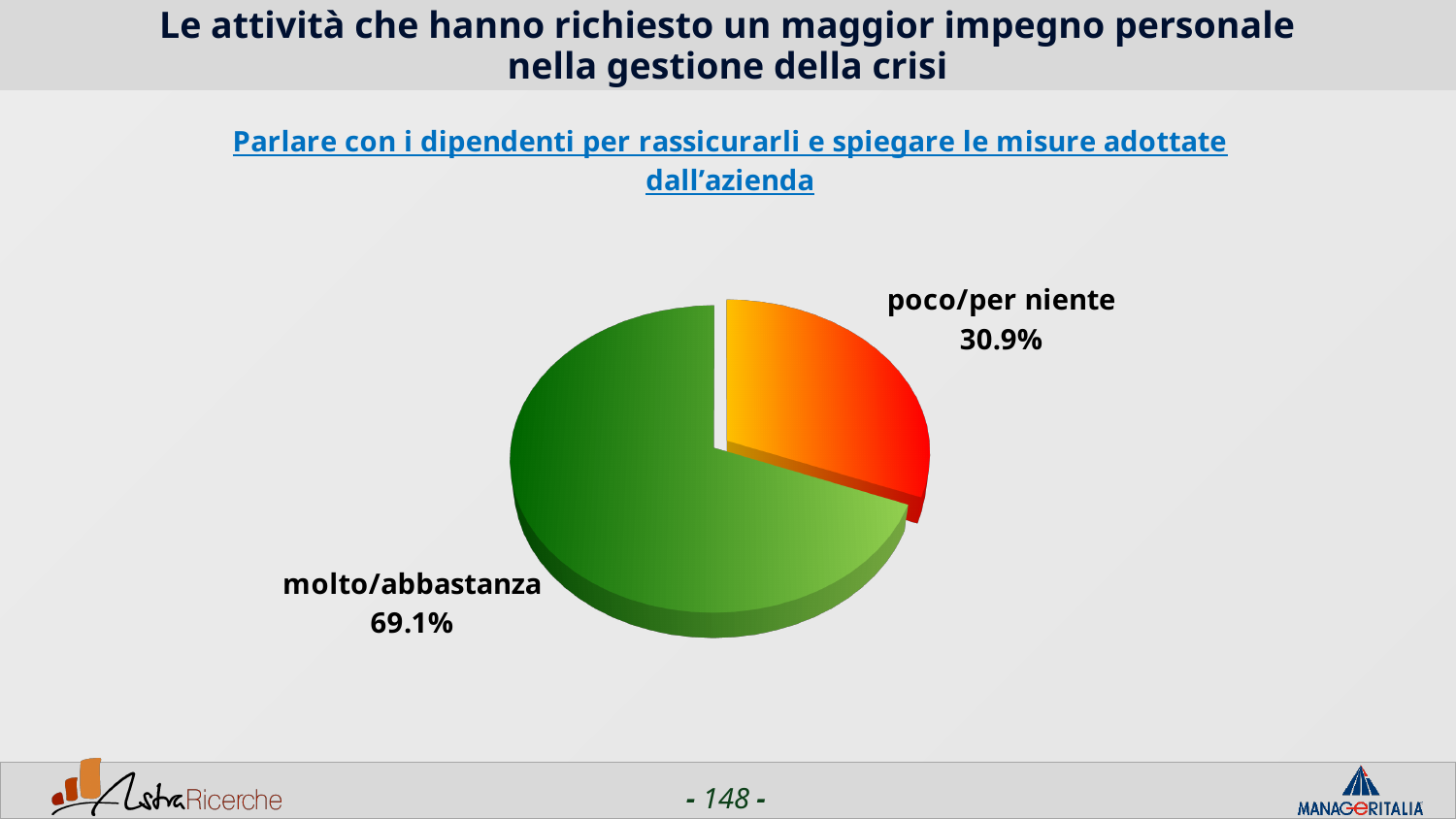
What share of the pie does the "poco/per niente" slice represent? 30.9% What is the subtitle (the underlined text) above the pie chart? Parlare con i dipendenti per rassicurarli e spiegare le misure adottate dall'azienda What percentage of the pie is labelled "molto/abbastanza"? 69.1% Which slice of the pie is the largest? molto/abbastanza What colour is the "molto/abbastanza" slice? green Which slice of the pie is the smallest? poco/per niente Which is larger, the "molto/abbastanza" slice or the "poco/per niente" slice? molto/abbastanza What kind of chart is shown on the slide? pie chart What is the difference in percentage points between the "molto/abbastanza" and "poco/per niente" slices? 38.2 What percentage of the pie is labelled "poco/per niente"? 30.9% How many slices does the pie chart have? 2